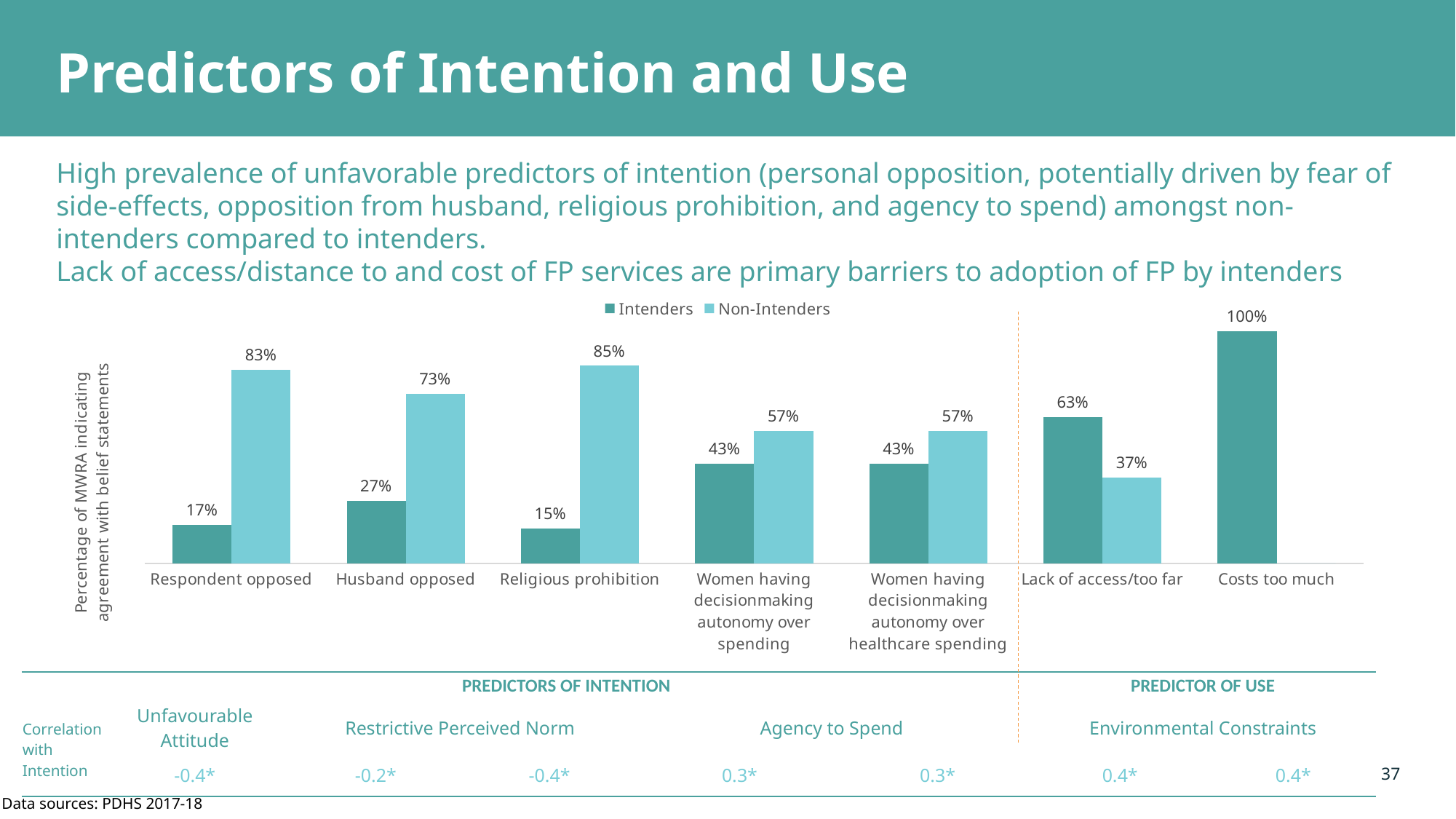
What is the Non-Intenders value for Respondent opposed? 83% What is the Intenders value for Lack of access/too far? 63% Which category has the highest Non-Intenders value? Religious prohibition How many series does the legend list? 2 Which category has the lowest Intenders value? Religious prohibition How many categories are shown on the x axis? 7 What is the Intenders value for Religious prohibition? 15% What is the difference between the Non-Intenders and Intenders values for Husband opposed? 46% What kind of chart is shown on the slide? Bar chart What is the Intenders value for Costs too much? 100% For Lack of access/too far, which series has the larger value, Intenders or Non-Intenders? Intenders What is the y-axis label of the chart? Percentage of MWRA indicating agreement with belief statements